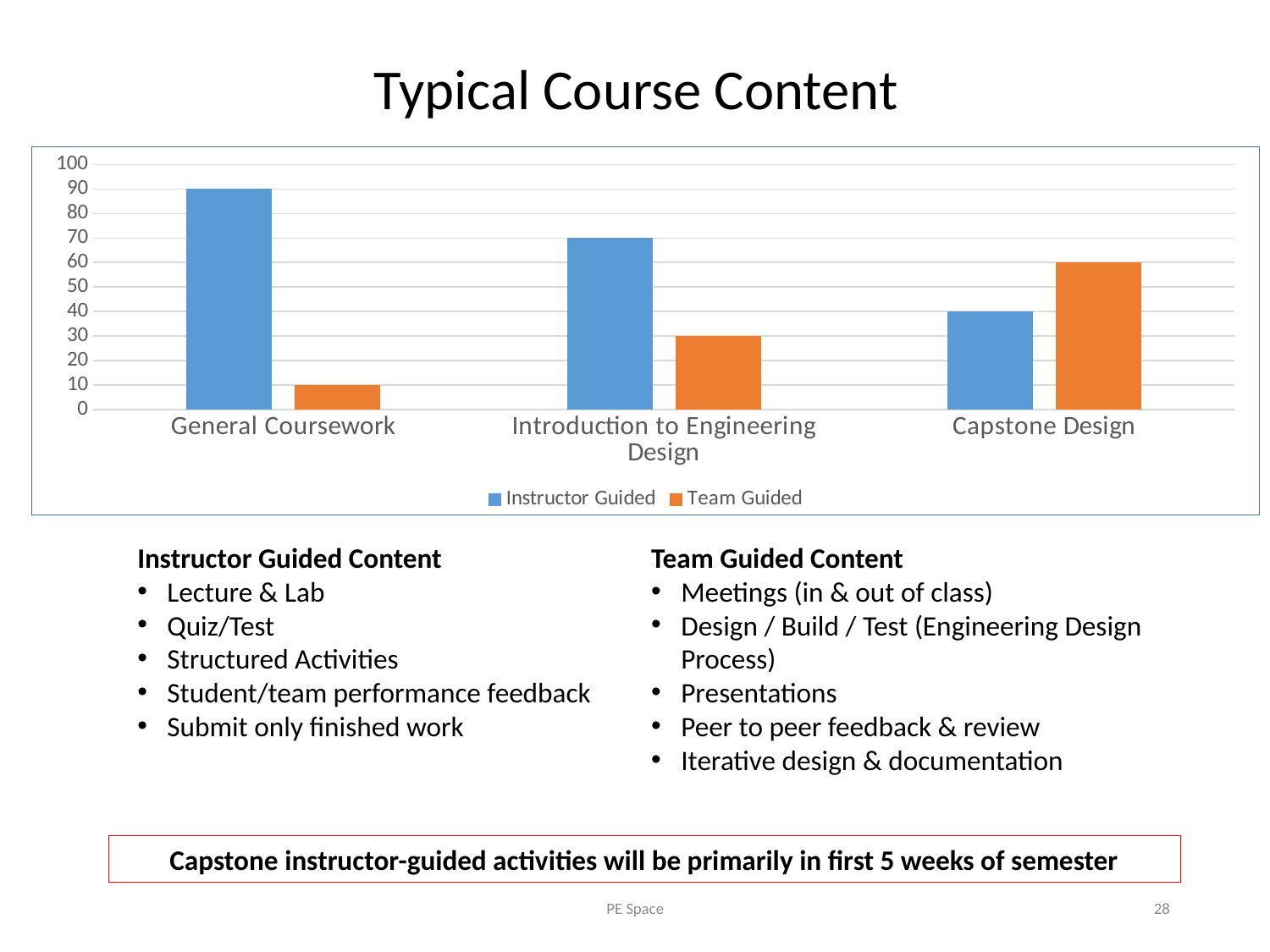
Is the Team Guided value for General Coursework greater or less than 20? less What is the Instructor Guided value for General Coursework? 90 What kind of chart is shown on the slide? bar chart Do the Instructor Guided values rise or fall from left to right across the categories? fall How many series does the legend list? 2 For Capstone Design, which is larger: Instructor Guided or Team Guided? Team Guided What is the Team Guided value for Capstone Design? 60 Which category has the highest Instructor Guided value? General Coursework How many categories are shown on the x axis? 3 What is the Instructor Guided value for Introduction to Engineering Design? 70 What is the difference between the Instructor Guided and Team Guided values for Introduction to Engineering Design? 40 Which category has the lowest Team Guided value? General Coursework